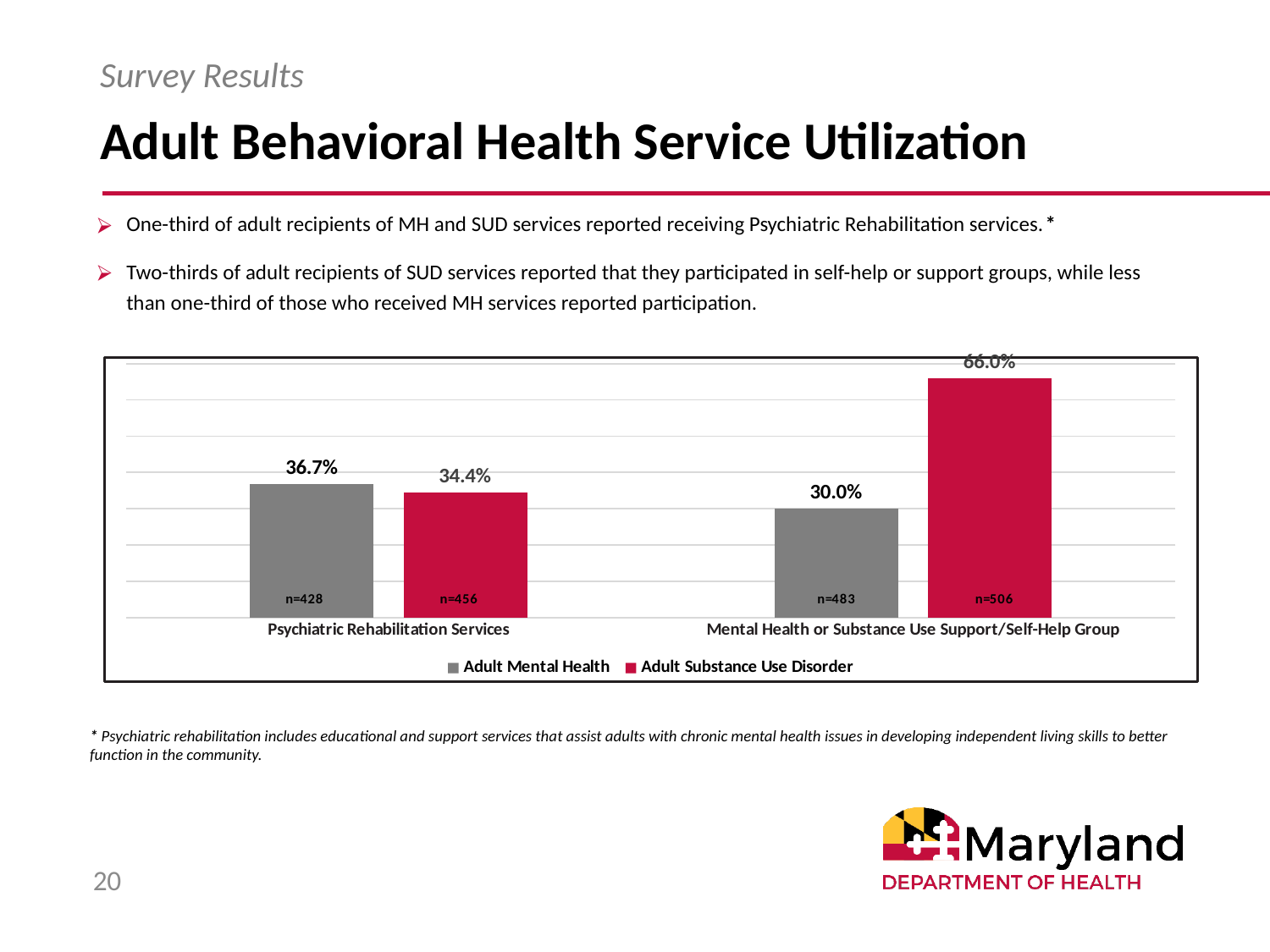
What is the difference between the Adult Mental Health and Adult Substance Use Disorder values for Psychiatric Rehabilitation Services? 2.3% How many series does the chart legend list? 2 Which bar has the lowest value on the chart? Adult Mental Health, Mental Health or Substance Use Support/Self-Help Group Which bar has the highest value on the chart? Adult Substance Use Disorder, Mental Health or Substance Use Support/Self-Help Group What is the difference between the Adult Substance Use Disorder and Adult Mental Health values for Mental Health or Substance Use Support/Self-Help Group? 36.0% What is the value for Adult Mental Health in the Psychiatric Rehabilitation Services category? 36.7% What is the value for Adult Substance Use Disorder in the Psychiatric Rehabilitation Services category? 34.4% What kind of chart is shown on the slide? Bar chart How many categories are shown on the x axis of the chart? 2 For Psychiatric Rehabilitation Services, which series has the larger value, Adult Mental Health or Adult Substance Use Disorder? Adult Mental Health What is the value for Adult Substance Use Disorder in the Mental Health or Substance Use Support/Self-Help Group category? 66.0% What is the value for Adult Mental Health in the Mental Health or Substance Use Support/Self-Help Group category? 30.0%